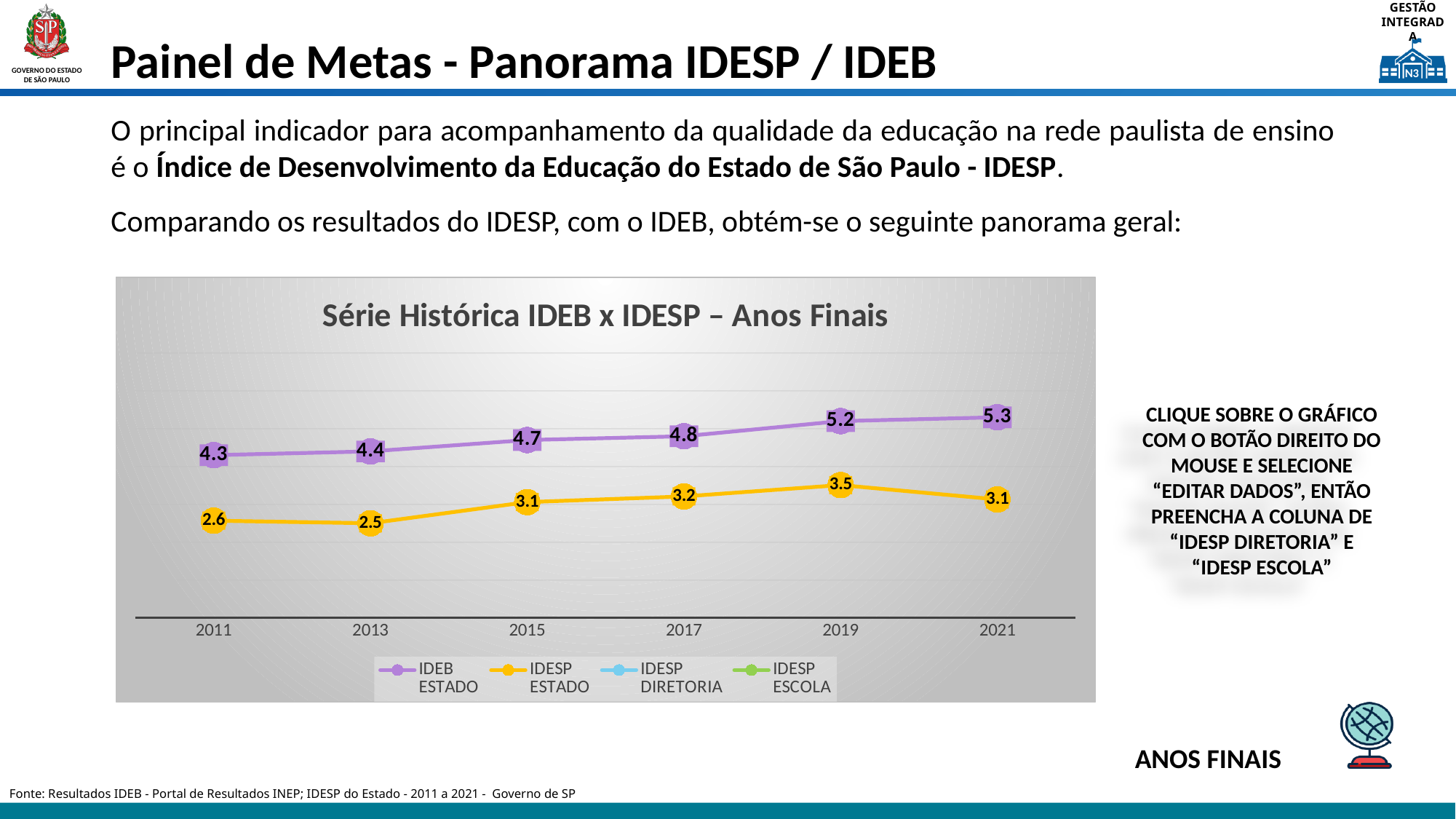
What is the IDESP ESTADO value for 2013? 2.5 What kind of chart is shown? line chart Which is larger: the IDESP ESTADO value in 2019 or in 2021? 2019 In which year is the IDEB ESTADO value highest? 2021 Does the IDEB ESTADO series rise or fall from 2011 to 2021? rise How many series does the legend list? 4 In which year is the IDESP ESTADO value lowest? 2013 What is the difference between the IDEB ESTADO and IDESP ESTADO values in 2017? 1.6 What is the IDEB ESTADO value for 2021? 5.3 What is the title of the chart? Série Histórica IDEB x IDESP – Anos Finais What is the IDESP ESTADO value for 2019? 3.5 How many years are shown on the x axis? 6